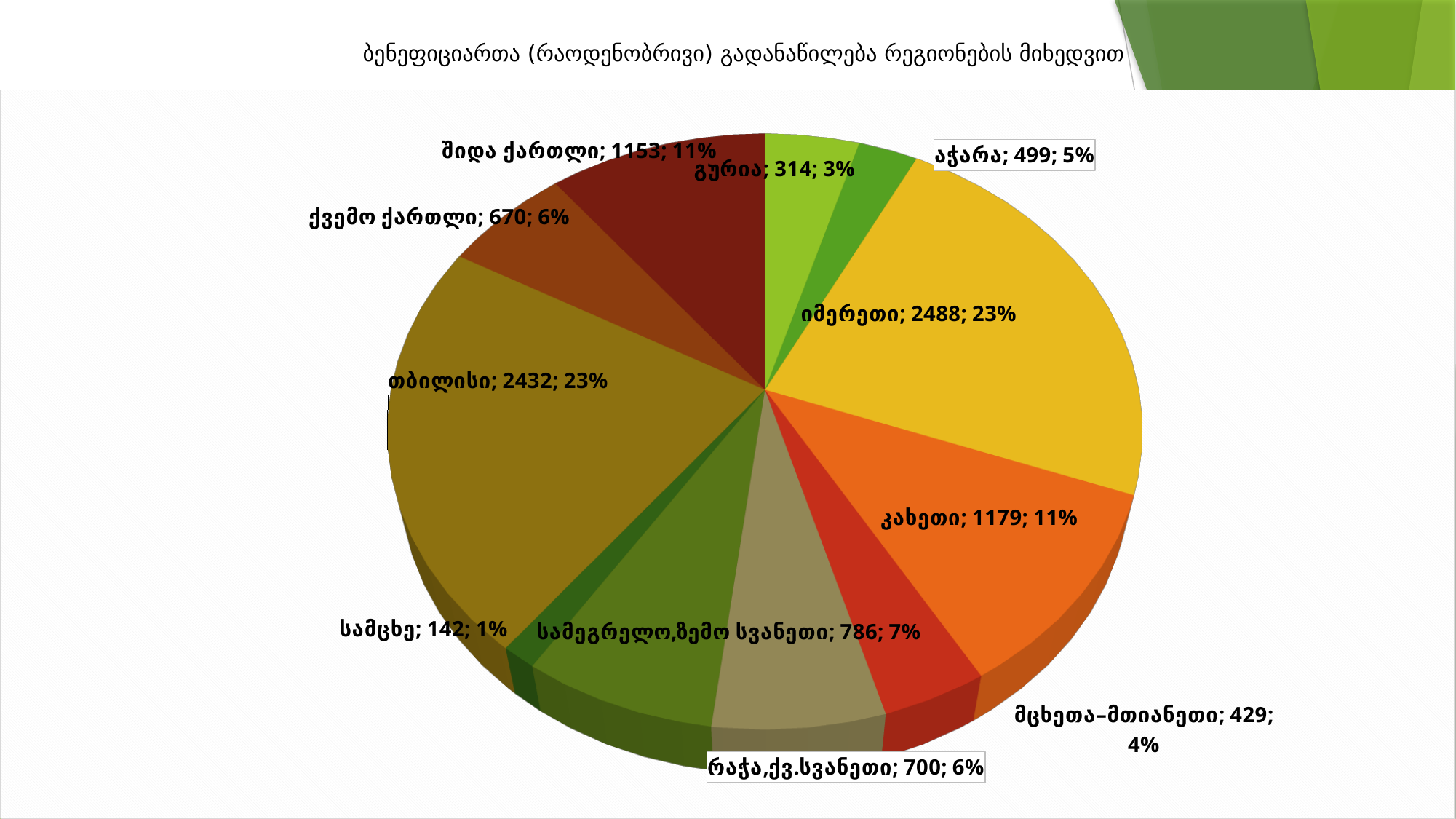
What is the difference between the values for შიდა ქართლი and ქვემო ქართლი? 483 What is the title of the chart? ბენეფიციართა (რაოდენობრივი) გადანაწილება რეგიონების მიხედვით What is the value for კახეთი? 1179 What share of the pie does მცხეთა-მთიანეთი represent? 4% Which is larger, the value for აჭარა or the value for გურია? აჭარა What kind of chart is shown on the slide? pie chart What is the value for იმერეთი? 2488 What share of the pie does თბილისი represent? 23% What is the value for სამცხე? 142 How many regions (slices) does the pie chart show? 11 Which region has the highest value? იმერეთი Which region has the lowest value? სამცხე